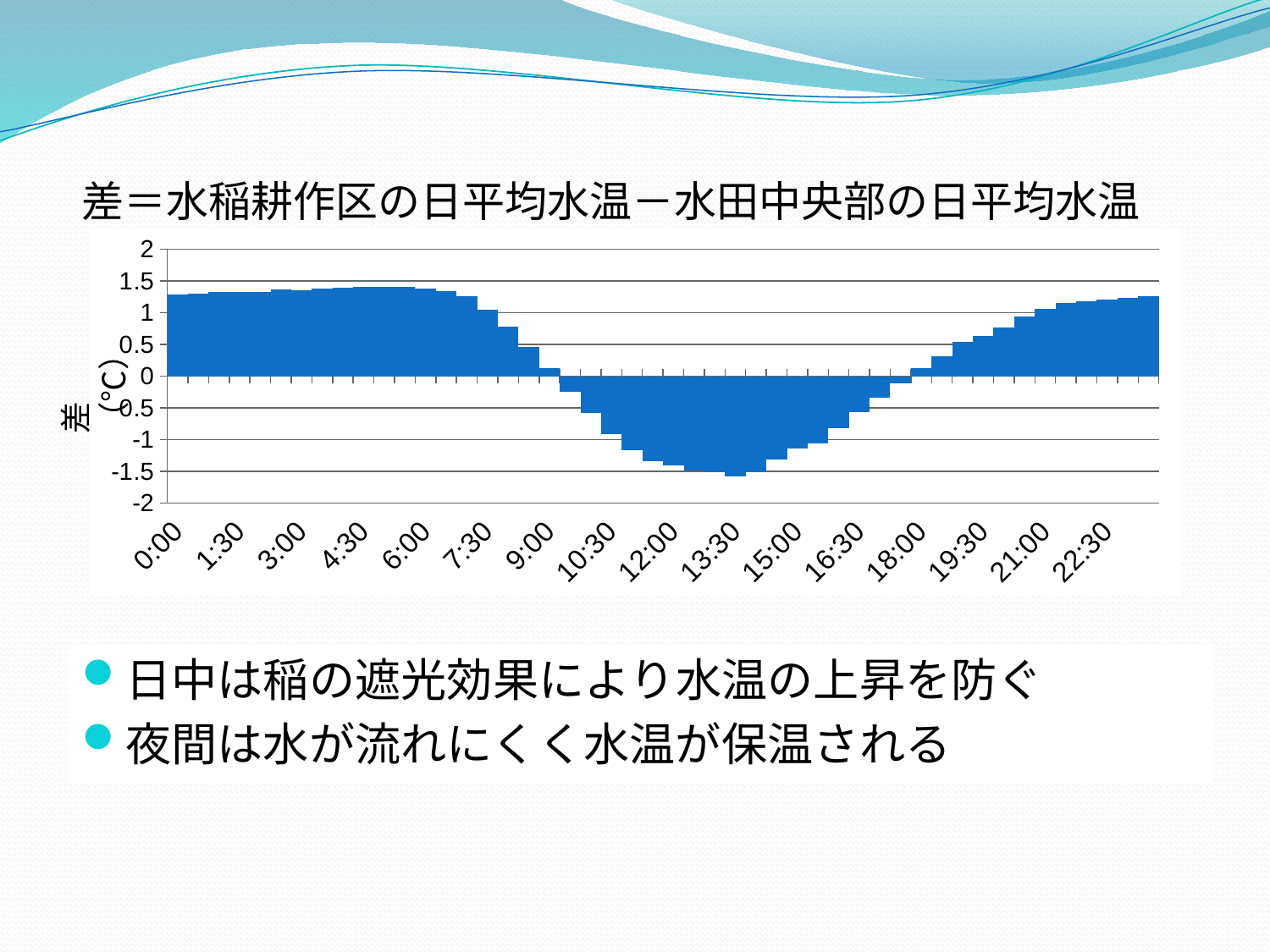
What is the label on the vertical axis of the chart? 差 (°C) Is the value at 12:00 greater or less than -0.5? less Do the values rise or fall from 6:00 to 13:30? fall Which is larger, the value at 12:00 or the value at 16:30? 16:30 What is the title shown above the chart? 差＝水稲耕作区の日平均水温－水田中央部の日平均水温 Is the value at 21:00 greater or less than 0.5? greater Which is larger, the value at 0:00 or the value at 13:30? 0:00 Is the value at 13:30 greater or less than -1? less What kind of chart is shown on the slide? bar chart